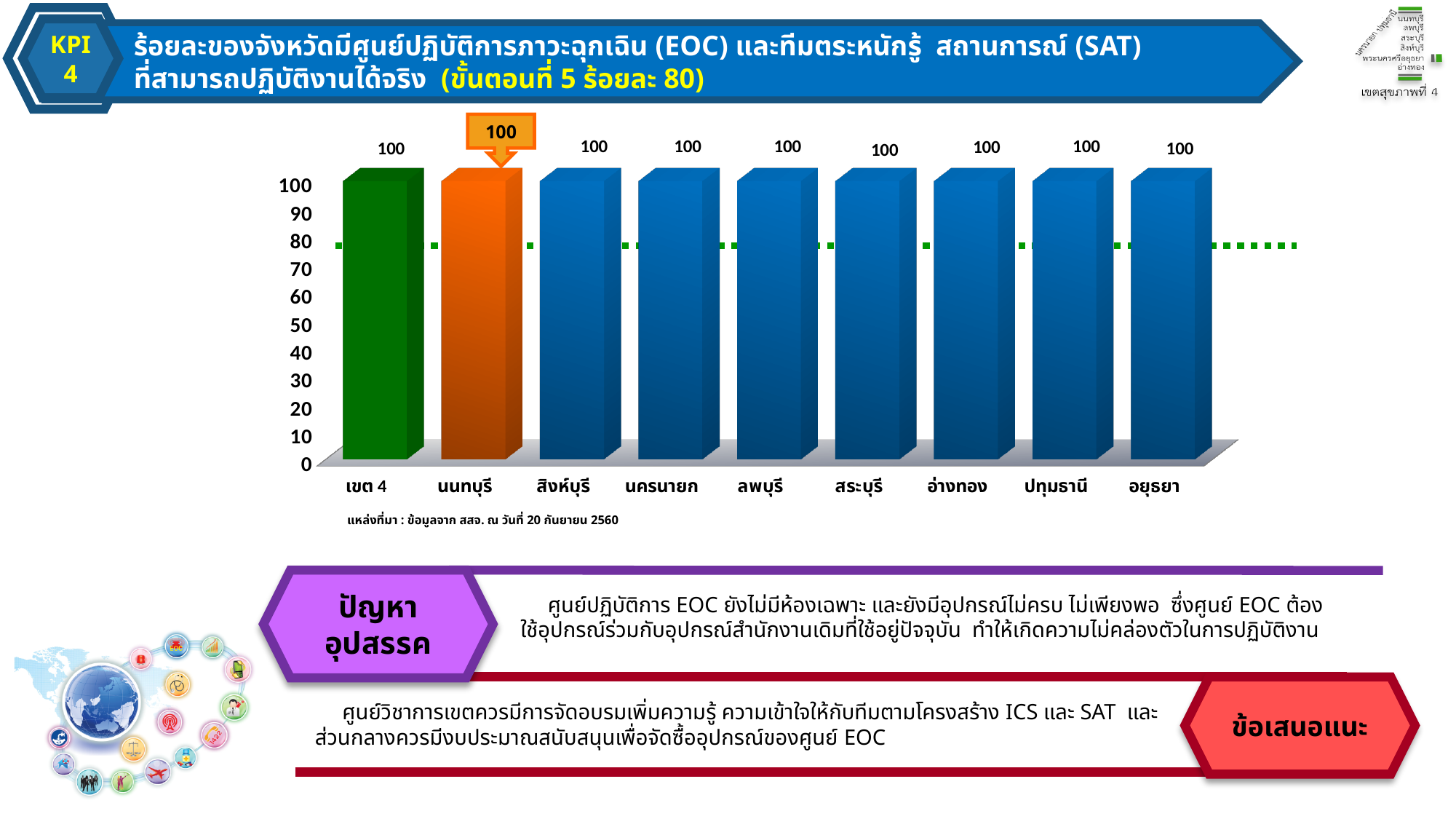
What is the value for สระบุรี? 100 Is the value for ลพบุรี greater or less than 80? greater What is the difference between the values for นนทบุรี and ปทุมธานี? 0 Is the value for อ่างทอง greater or less than 50? greater What is the value for เขต 4? 100 What is the value for อยุธยา? 100 How many categories are shown on the x axis of the chart? 9 What kind of chart is shown on the slide? bar chart At what value is the green dotted horizontal line drawn on the chart? 80 Do the values rise, fall, or stay the same across the categories from left to right? stay the same What is the value for นนทบุรี? 100 Which category's bar is coloured orange? นนทบุรี